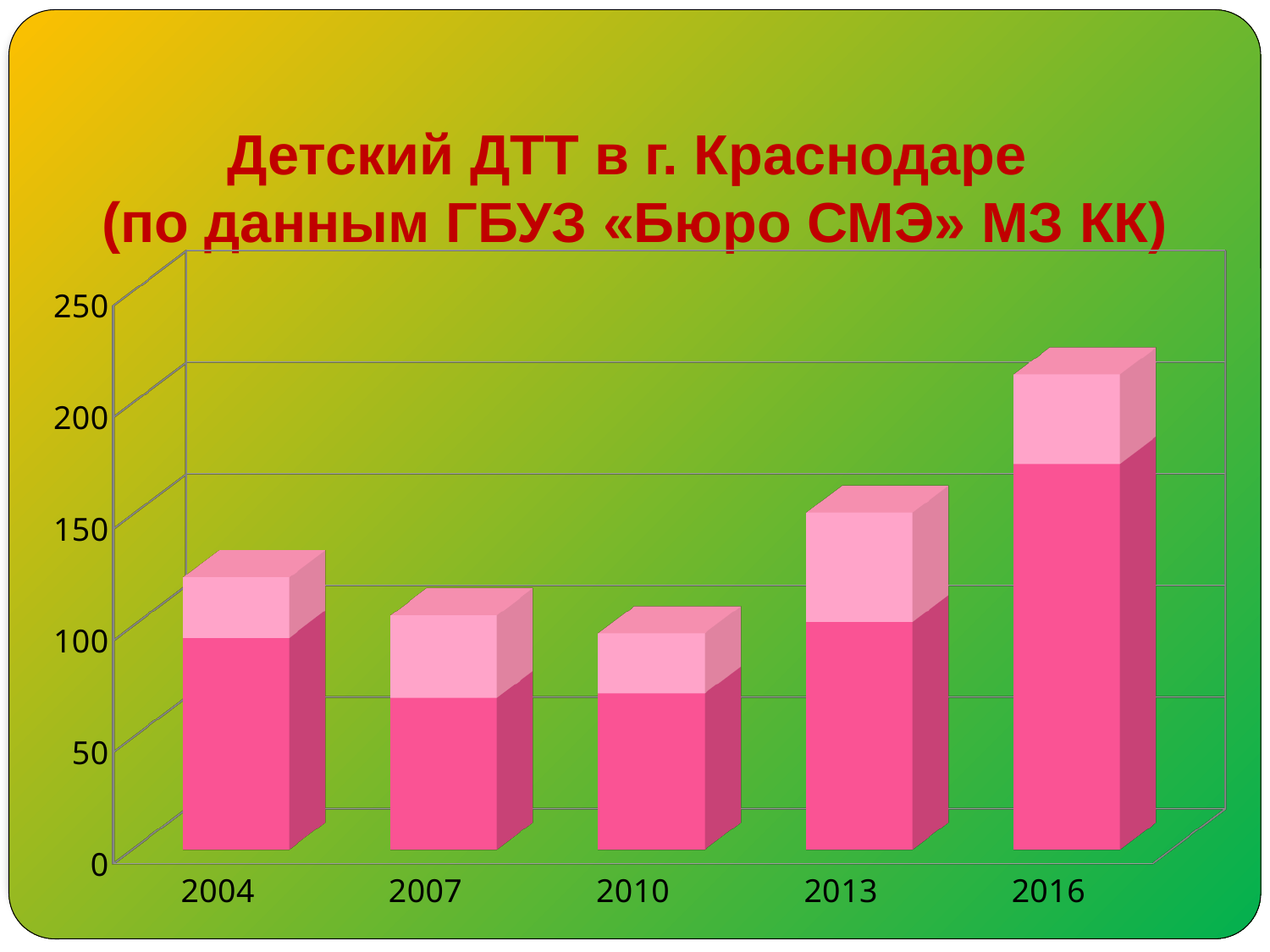
What is the highest tick value shown on the vertical axis of the chart? 250 Is the value for 2004 greater or less than 50? greater Is the value for 2016 greater or less than 150? greater Do the values rise or fall from 2010 to 2016? rise Which year has the highest bar in the chart? 2016 Is the value for 2007 greater or less than 50? greater Which is larger, the value for 2016 or the value for 2004? 2016 Which is larger, the value for 2013 or the value for 2007? 2013 How many years are shown on the x axis of the chart? 5 What kind of chart is shown on the slide? bar chart